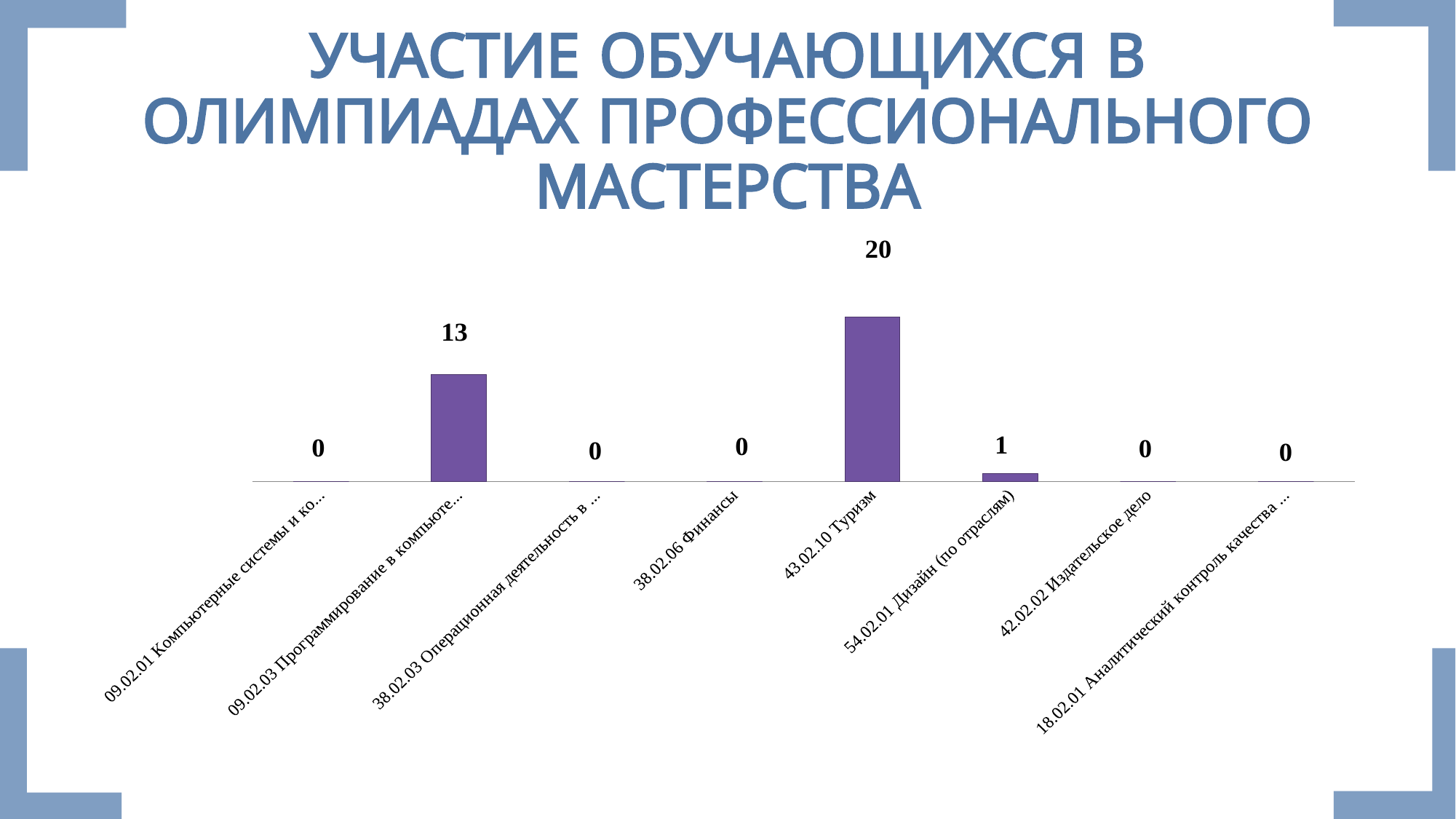
What is the value for 38.02.06 Финансы? 0 What is the value for 42.02.02 Издательское дело? 0 What is the value for the category 09.02.03 Программирование в компьюте...? 13 Which category has the highest value? 43.02.10 Туризм How many categories are shown on the x axis? 8 How many categories have a value of 0? 5 What is the difference between the values for 09.02.03 Программирование в компьюте... and 54.02.01 Дизайн (по отраслям)? 12 Which is larger, the value for 43.02.10 Туризм or the value for 54.02.01 Дизайн (по отраслям)? 43.02.10 Туризм What is the value for 43.02.10 Туризм? 20 What is the difference between the values for 43.02.10 Туризм and 09.02.03 Программирование в компьюте...? 7 What kind of chart is shown on the slide? Bar chart What is the value for 54.02.01 Дизайн (по отраслям)? 1